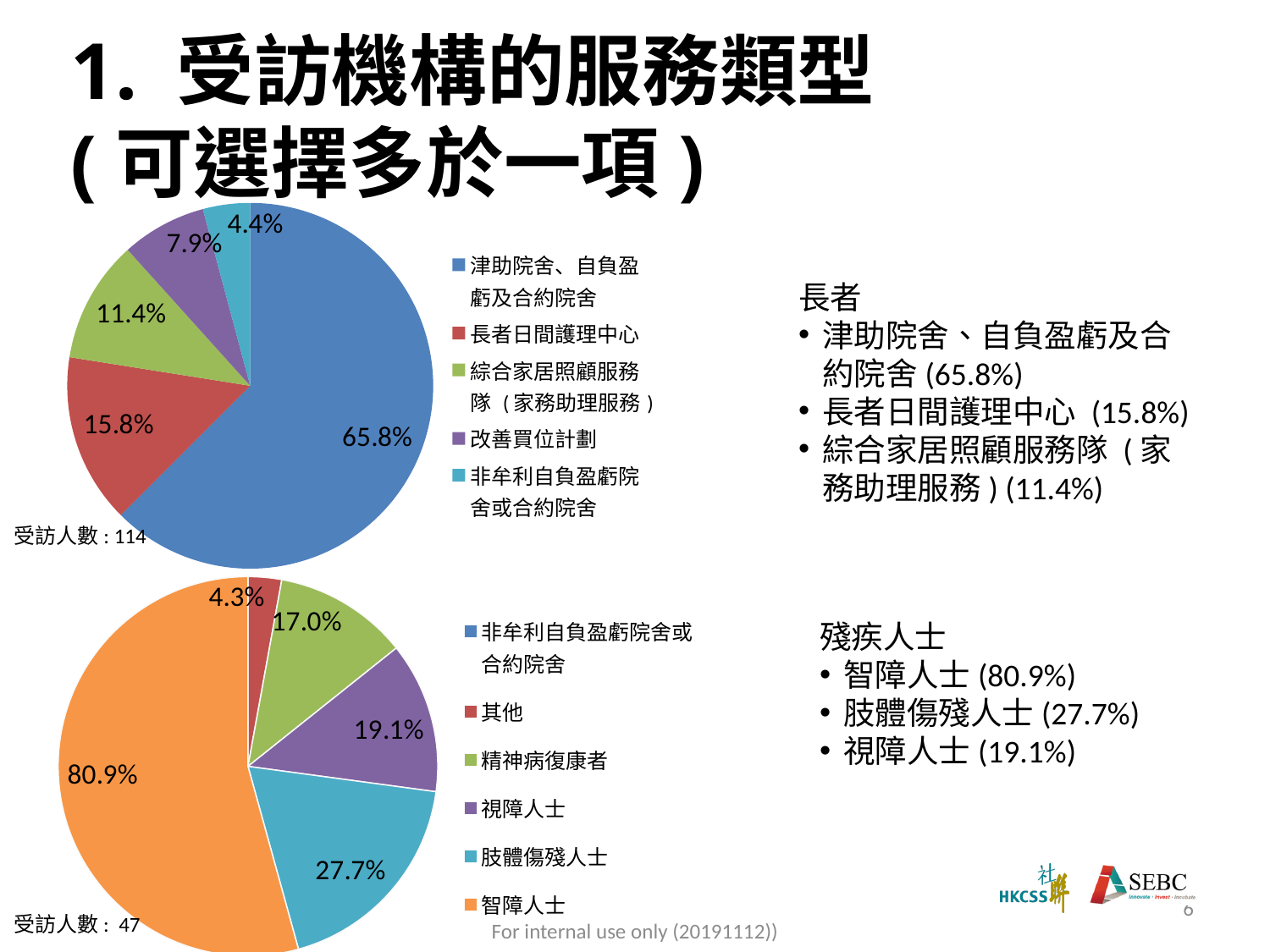
In the top pie chart, which category has the smallest slice? 非牟利自負盈虧院舍或合約院舍 In the top pie chart, what is the difference between 長者日間護理中心 and 綜合家居照顧服務隊（家務助理服務）? 4.4% In the bottom pie chart, what is the value for 智障人士? 80.9% In the top pie chart, what is the value for 津助院舍、自負盈虧及合約院舍? 65.8% In the bottom pie chart, which is larger: 視障人士 or 精神病復康者? 視障人士 In the bottom pie chart, what is the value for 肢體傷殘人士? 27.7% How many entries does the legend of the bottom pie chart list? 6 In the top pie chart, what is the value for 改善買位計劃? 7.9% In the bottom pie chart, which category has the largest slice? 智障人士 How many entries does the legend of the top pie chart list? 5 In the top pie chart, what is the value for 長者日間護理中心? 15.8% What type of chart is the top chart on the slide? pie chart